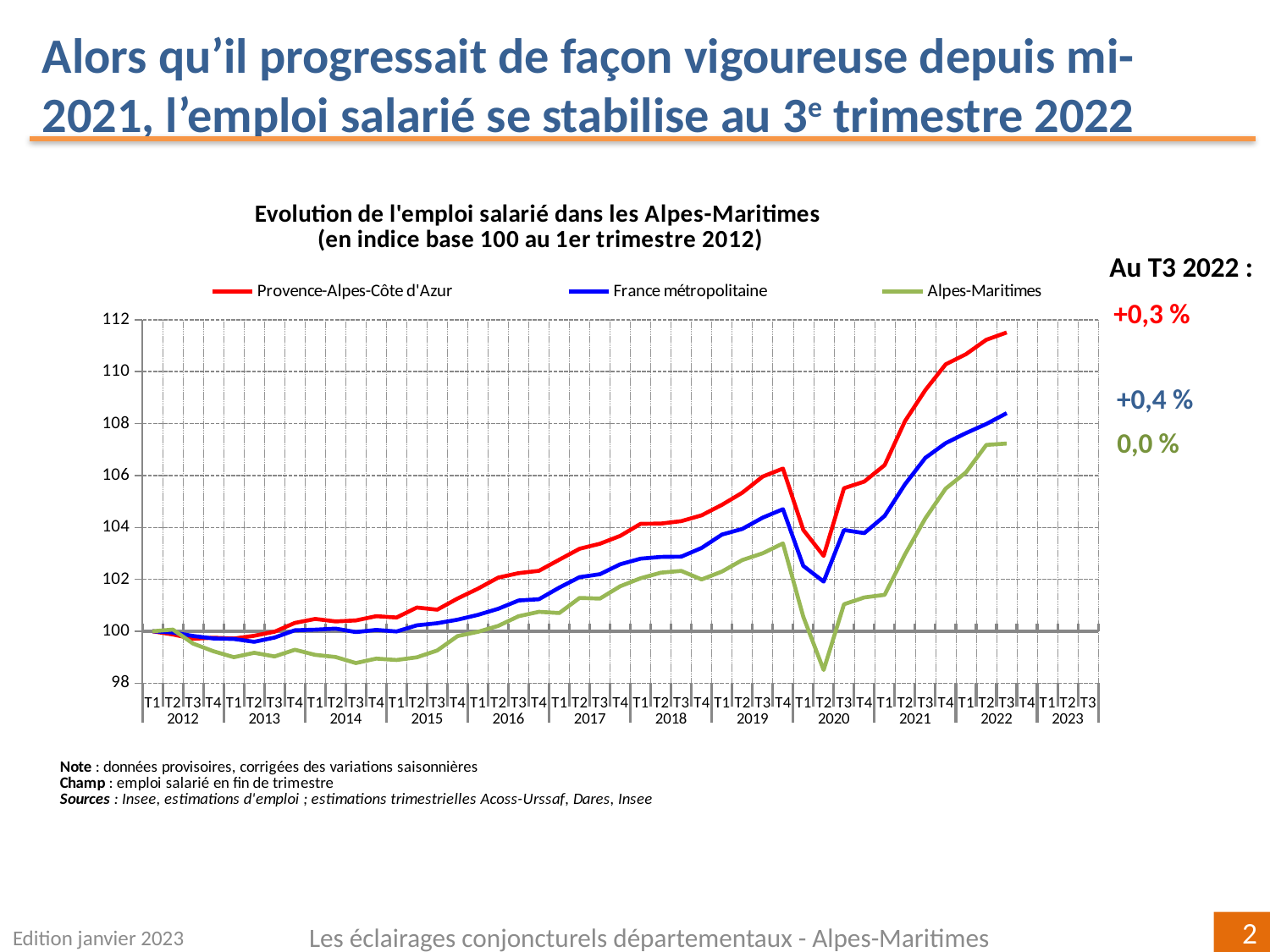
How many series does the legend of the chart list? 3 Which series has the lowest value at T2 2020? Alpes-Maritimes Is the value for Provence-Alpes-Côte d'Azur at T3 2022 greater or less than 110? greater Which series has the highest value at T3 2022? Provence-Alpes-Côte d'Azur According to the annotation, what is the change for Provence-Alpes-Côte d'Azur at T3 2022? +0,3 % Is the value for France métropolitaine at T3 2022 greater or less than 106? greater Which three series are listed in the chart legend? Provence-Alpes-Côte d'Azur, France métropolitaine, Alpes-Maritimes Is the value for Alpes-Maritimes at T2 2020 greater or less than 100? less According to the annotation, what is the change for France métropolitaine at T3 2022? +0,4 % According to the annotation, what is the change for Alpes-Maritimes at T3 2022? 0,0 % What is the title of the chart? Evolution de l'emploi salarié dans les Alpes-Maritimes (en indice base 100 au 1er trimestre 2012) What type of chart is shown on the slide? line chart